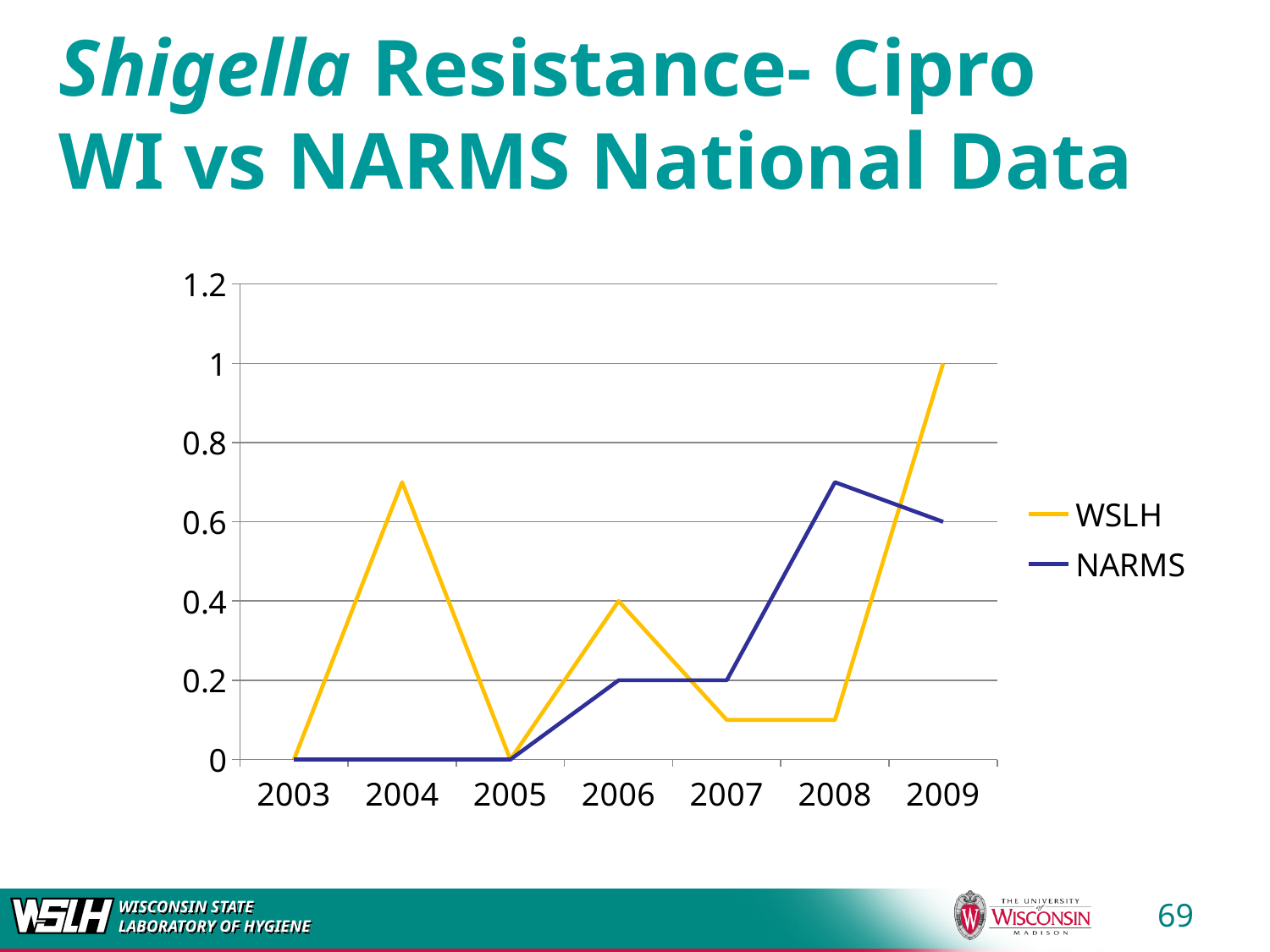
Is the WSLH value for 2004 greater or less than 0.6? greater What is the NARMS value for 2006? 0.2 What colour is the WSLH line? yellow In which year is the WSLH value highest? 2009 What is the WSLH value for 2009? 1 Is the NARMS value for 2008 greater or less than 0.6? greater What type of chart is shown on the slide? line chart How many years are shown on the x axis? 7 How many series does the legend list? 2 In 2008, which series has the larger value, WSLH or NARMS? NARMS What is the NARMS value for 2009? 0.6 What is the WSLH value for 2006? 0.4